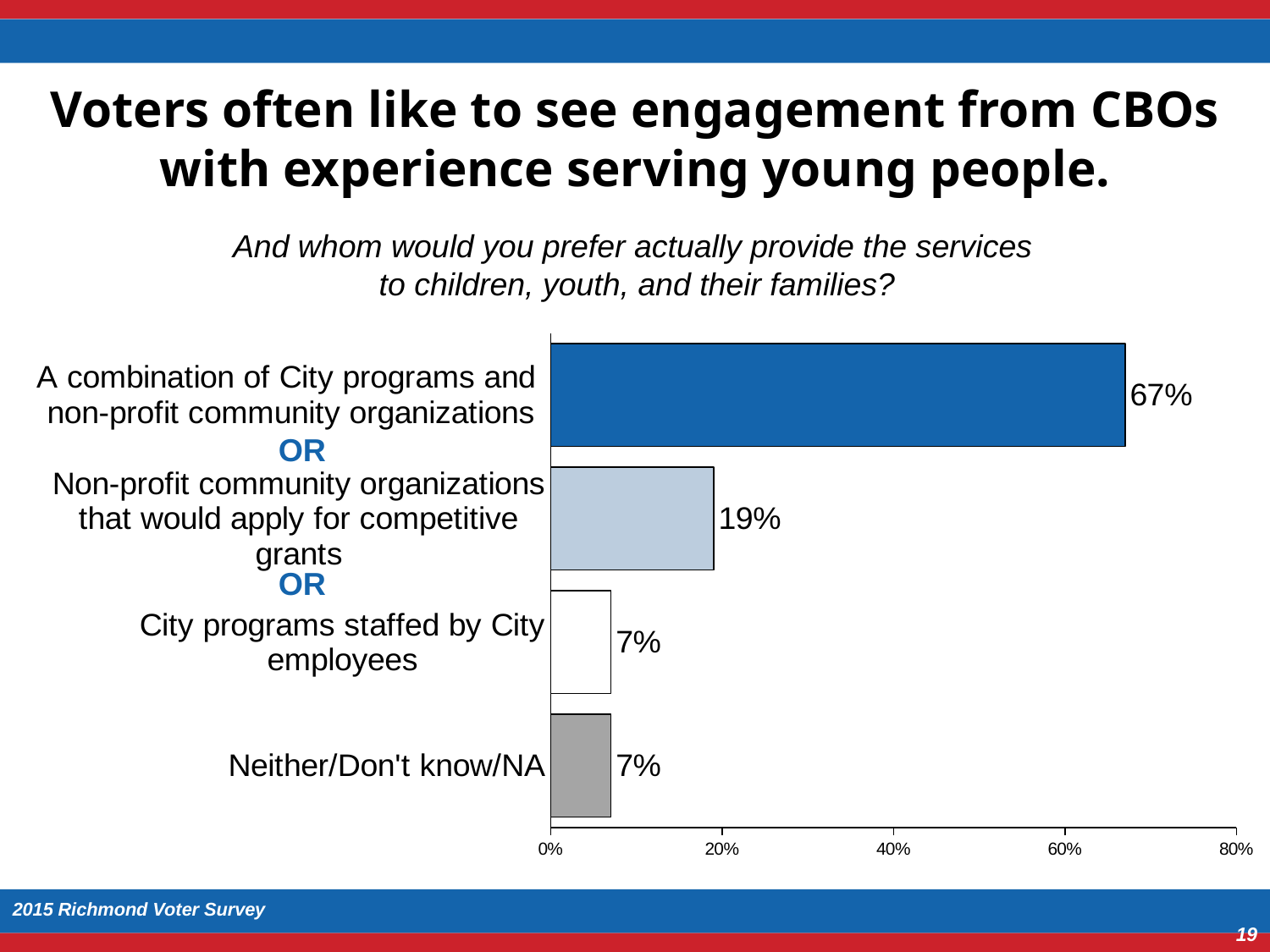
Which is larger: the percentage for non-profit community organizations that would apply for competitive grants, or the percentage for City programs staffed by City employees? Non-profit community organizations that would apply for competitive grants Which response option has the highest percentage? A combination of City programs and non-profit community organizations How many response categories are shown in the chart? 4 What is the difference in percentage points between the combination option and the non-profit competitive grants option? 48 What is the maximum value shown on the horizontal axis? 80% What is the difference in percentage points between the non-profit competitive grants option and City programs staffed by City employees? 12 What percentage of voters prefer non-profit community organizations that would apply for competitive grants? 19% What percentage of voters prefer City programs staffed by City employees? 7% What type of chart is shown on the slide? Bar chart What percentage of voters answered Neither/Don't know/NA? 7% Is the value for the combination of City programs and non-profit community organizations greater or less than 60%? greater What percentage of voters prefer a combination of City programs and non-profit community organizations? 67%